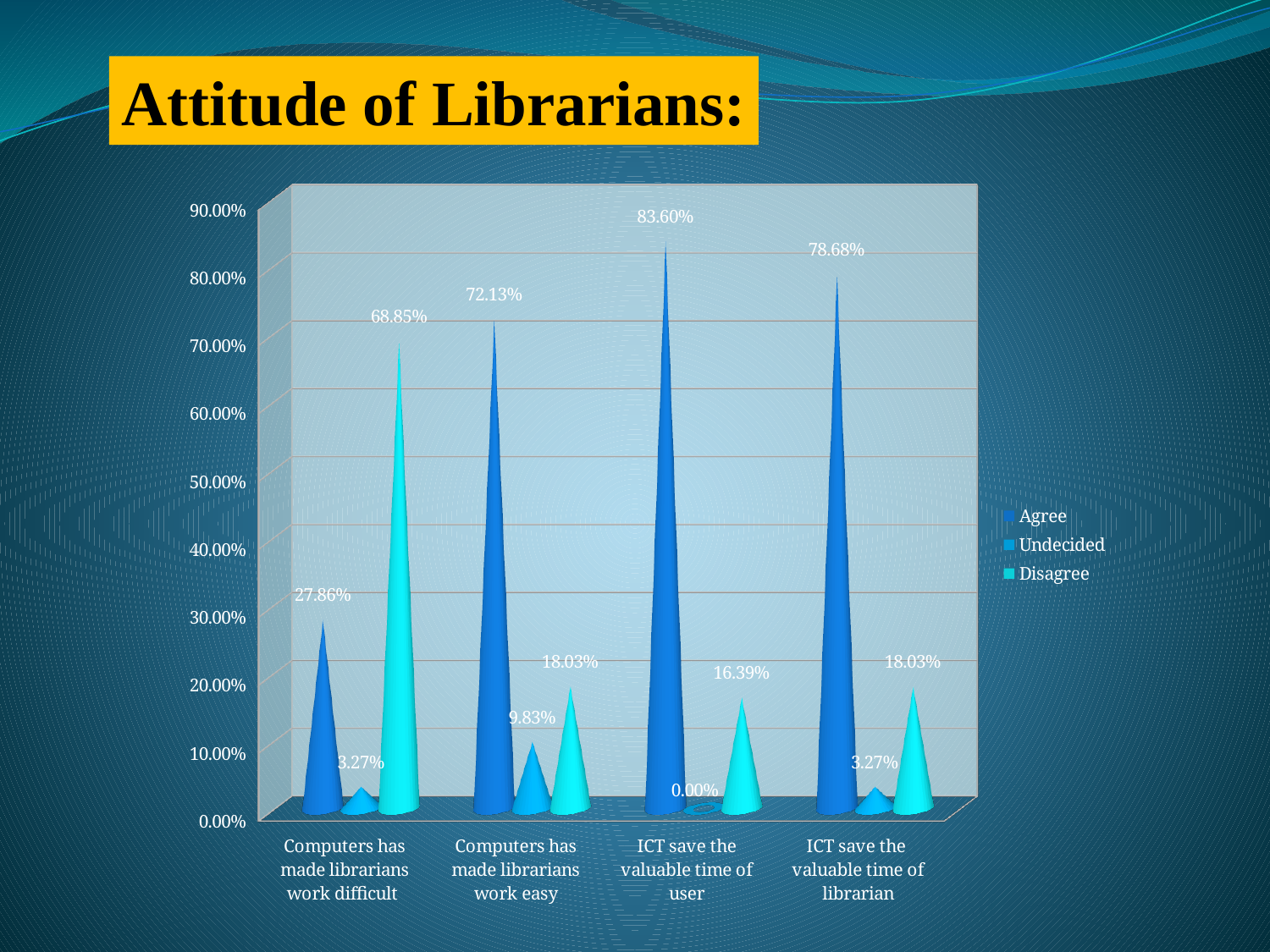
What is the Agree value for "ICT save the valuable time of user"? 83.60% What is the difference between the Agree values for "ICT save the valuable time of user" and "ICT save the valuable time of librarian"? 4.92% What is the Agree value for "ICT save the valuable time of librarian"? 78.68% Which category has the lowest Undecided value? ICT save the valuable time of user What kind of chart is shown on the slide? Bar chart How many categories are shown on the x axis? 4 What is the title of the slide? Attitude of Librarians: How many series does the legend list? 3 What is the Undecided value for "Computers has made librarians work easy"? 9.83% What is the Disagree value for "Computers has made librarians work difficult"? 68.85% Which is larger for "Computers has made librarians work difficult": the Agree value or the Disagree value? Disagree Which category has the highest Agree value? ICT save the valuable time of user